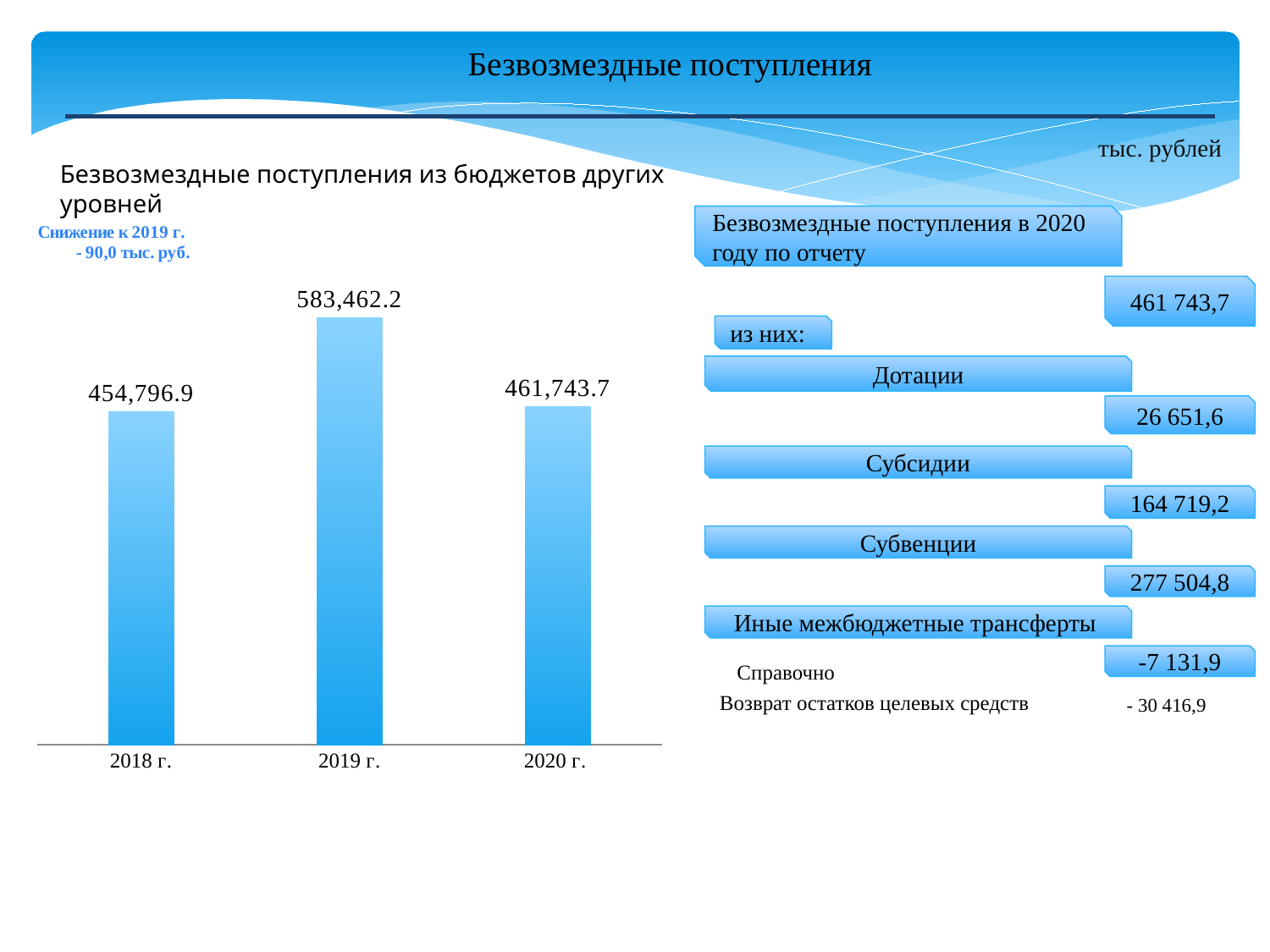
What kind of chart is shown on the slide? bar chart Which is larger in the bar chart, the value for 2020 г. or the value for 2018 г.? 2020 г. Which year has the lowest value in the bar chart? 2018 г. What is the value for 2020 г. in the bar chart? 461,743.7 Which year has the highest value in the bar chart? 2019 г. What is the value for 2019 г. in the bar chart? 583,462.2 What is the value for 2018 г. in the bar chart? 454,796.9 What is the difference between the values for 2019 г. and 2020 г. in the bar chart? 121,718.5 Do the values in the bar chart rise or fall from 2019 г. to 2020 г.? fall What is the difference between the values for 2019 г. and 2018 г. in the bar chart? 128,665.3 How many years are shown in the bar chart? 3 What is the title of the bar chart? Безвозмездные поступления из бюджетов других уровней